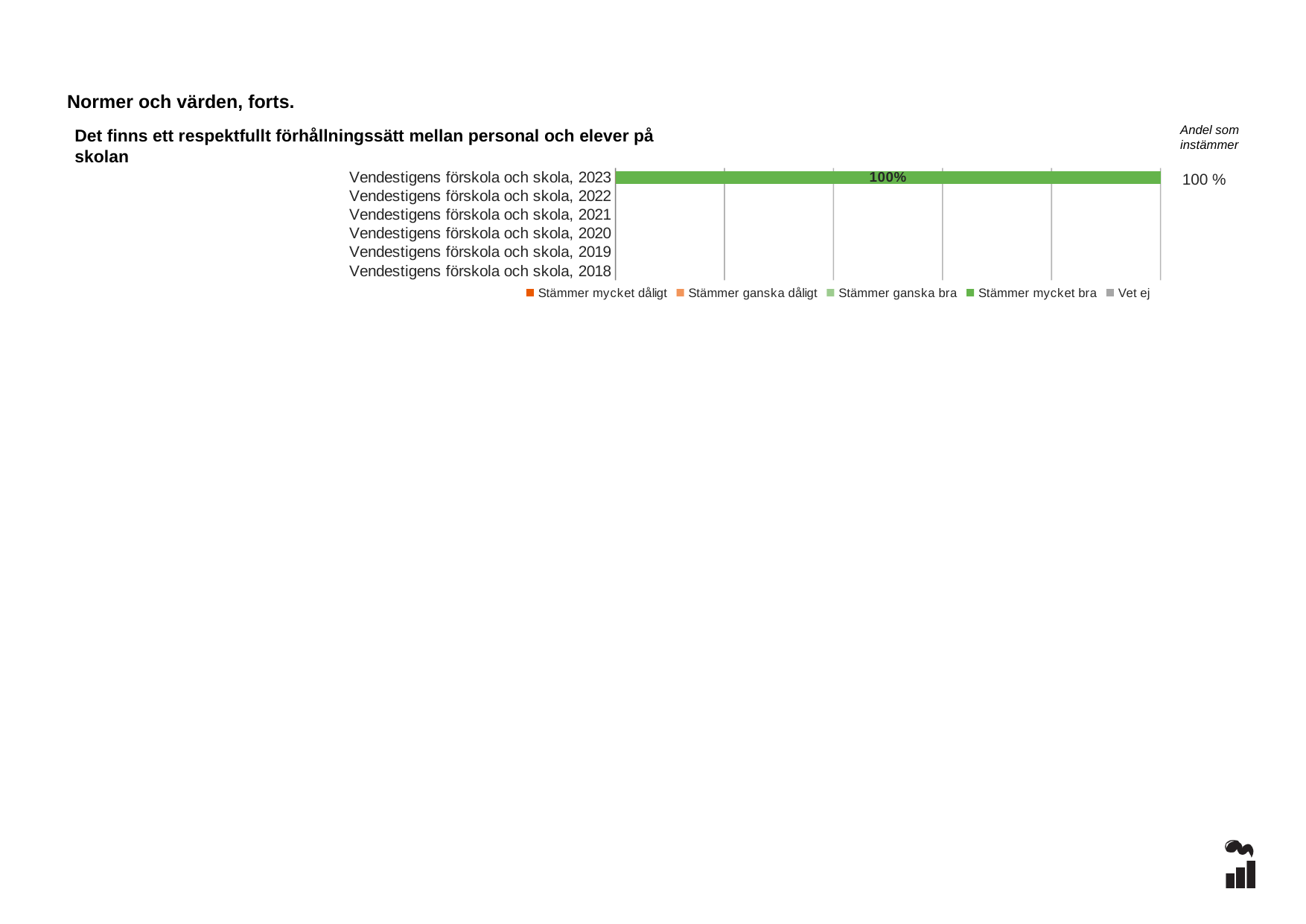
How many categories are listed on the vertical axis of the chart? 6 What is the first legend entry of the chart? Stämmer mycket dåligt Which category is listed at the bottom of the chart's vertical axis? Vendestigens förskola och skola, 2018 What kind of chart is shown on the slide? bar chart What is the 'Andel som instämmer' value shown for Vendestigens förskola och skola, 2023? 100 % How many series does the legend list? 5 Which category has the highest plotted value in the chart? Vendestigens förskola och skola, 2023 Which legend entry does the only plotted bar in the chart belong to? Stämmer mycket bra What is the value of the 'Stämmer mycket bra' segment for Vendestigens förskola och skola, 2023? 100% What is the total of the stacked bar for Vendestigens förskola och skola, 2023? 100%